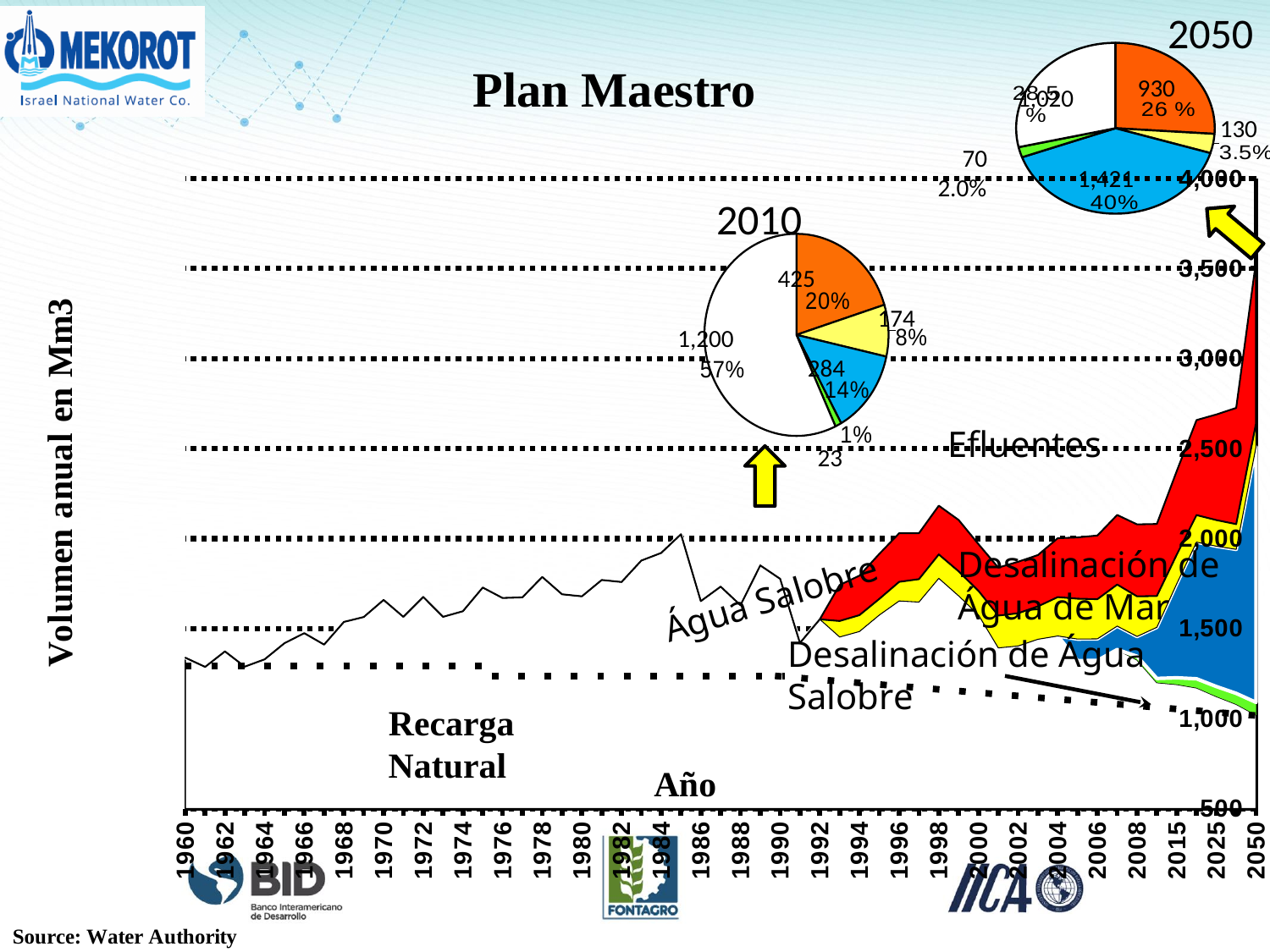
In the 2010 pie chart, what percentage share is shown for the 1,200 slice? 57% In the 2050 pie chart, what value is shown for the slice labelled 40%? 1,421 What kind of chart is the main chart plotted against the years 1960 to 2050? area chart In the 2050 pie chart, which is larger, the 930 slice or the 130 slice? 930 In the 2010 pie chart, which slice is the largest? 1,200 (57%) In the 2010 pie chart, which slice is the smallest? 23 (1%) What is the y-axis title of the main area chart? Volumen anual en Mm3 How many slices does the 2010 pie chart have? 5 In the main area chart, is the total value at 2050 greater or less than 3,500? greater In the 2010 pie chart, what value is shown for the slice labelled 20%? 425 In the 2050 pie chart, what percentage share is shown for the 930 slice? 26 % In the 2010 pie chart, what is the difference between the 425 slice and the 174 slice? 251